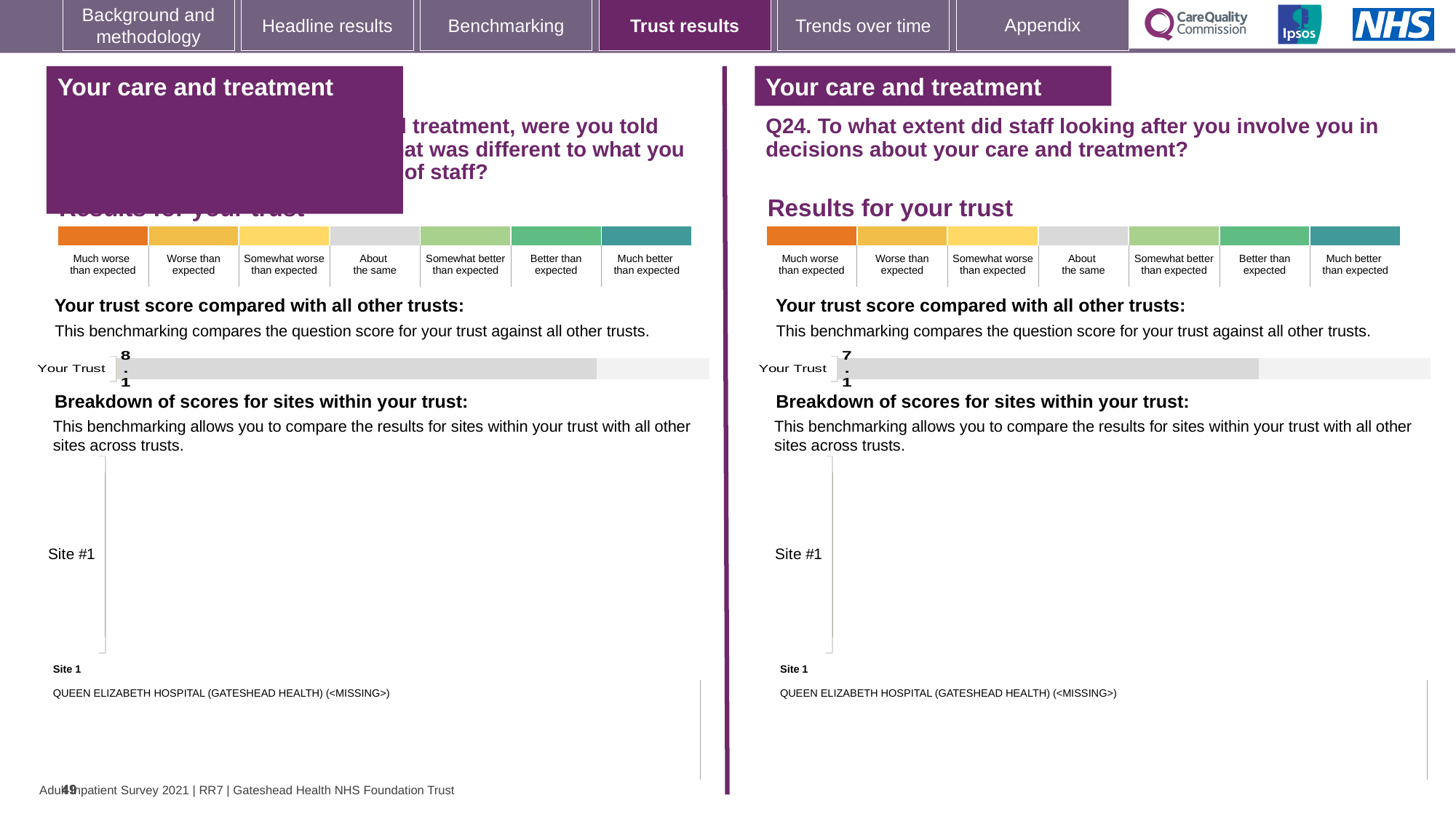
How many categories are plotted in the left panel's 'Your trust score compared with all other trusts' chart? 1 Which panel's Your Trust score is larger, the left panel or the right panel (Q24)? Left panel How many sites are listed in the right panel's 'Breakdown of scores for sites within your trust' chart? 1 What kind of chart is used to show the Your Trust score on the right panel (Q24)? Bar chart On the right panel (Q24) 'Your trust score compared with all other trusts' chart, what is the value shown for Your Trust? 7.1 What is the label of the single category in the right panel's trust score chart? Your Trust Which site is named under 'Site 1' in the left panel's site breakdown? QUEEN ELIZABETH HOSPITAL (GATESHEAD HEALTH) (<MISSING>) How many rating bands are shown in the colour scale above the right panel's 'Your trust score' chart, from 'Much worse than expected' to 'Much better than expected'? 7 What is the difference between the left panel's Your Trust score (8.1) and the right panel's Q24 Your Trust score (7.1)? 1.0 On the left panel's 'Your trust score compared with all other trusts' chart, what is the value shown for Your Trust? 8.1